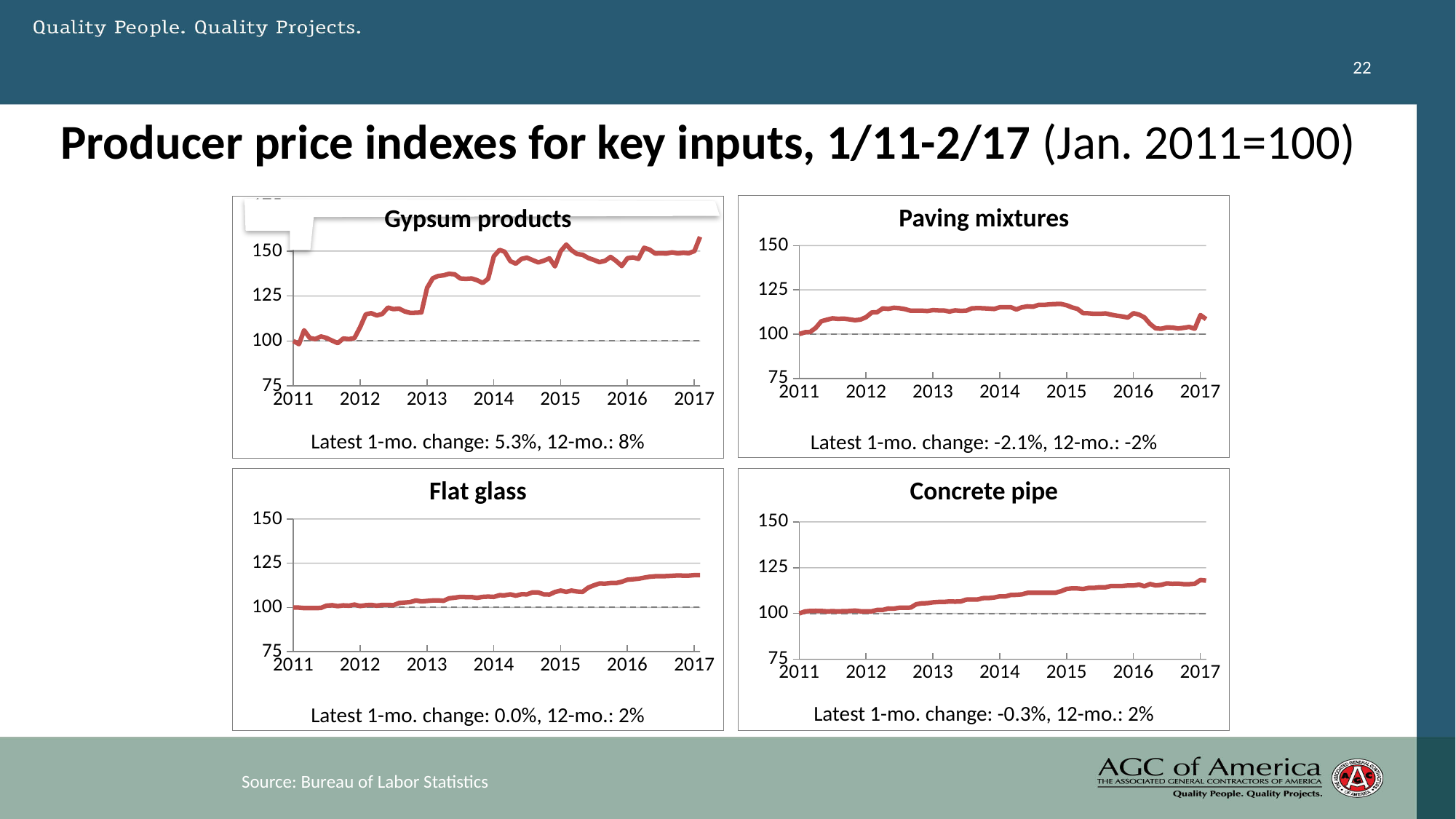
What is the 12-month change shown for Paving mixtures? -2% In the Flat glass chart, does the index rise or fall from 2011 to 2017? rise How many charts are shown on the slide? 4 What is the latest 1-month change shown for Gypsum products? 5.3% In the Concrete pipe chart, is the value at 2017 greater or less than 100? greater In the Concrete pipe chart, does the index rise or fall from 2011 to 2017? rise In the Paving mixtures chart, is the value at 2017 greater or less than 125? less Which of the four charts shows the highest index value at 2017? Gypsum products In the Flat glass chart, is the value at 2017 greater or less than 125? less What kind of chart is used for Gypsum products? line chart